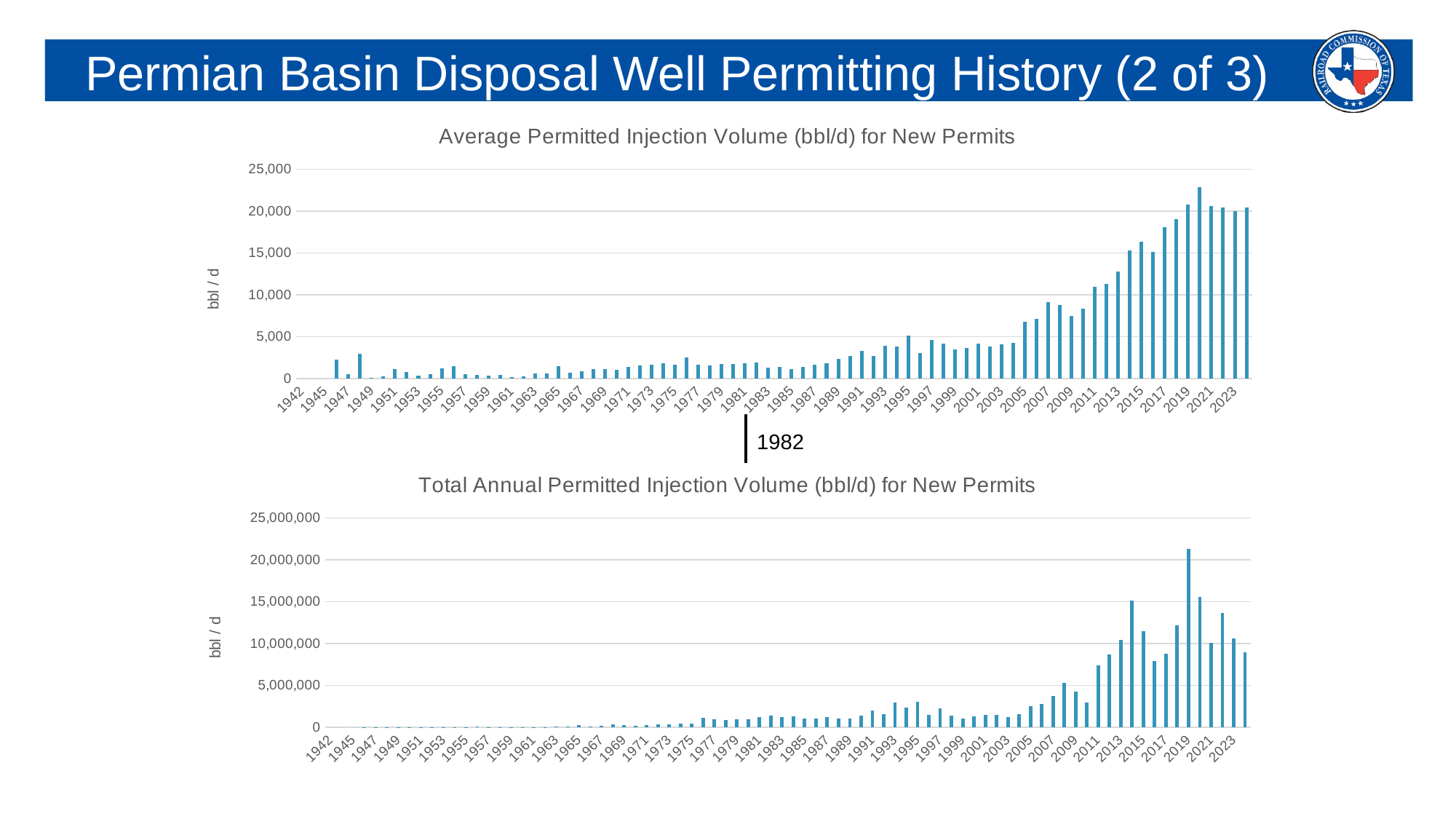
In the top chart (Average Permitted Injection Volume), which year has the highest value? 2020 In the bottom chart (Total Annual Permitted Injection Volume), is the value for 2016 greater or less than 10,000,000? less In the top chart (Average Permitted Injection Volume), is the value for 1982 greater or less than 5,000? less What is the y-axis label on the bottom chart (Total Annual Permitted Injection Volume)? bbl / d In the top chart (Average Permitted Injection Volume), is the value for 2020 greater or less than 20,000? greater In the top chart (Average Permitted Injection Volume), which year has the larger value, 2010 or 2020? 2020 In the bottom chart (Total Annual Permitted Injection Volume), which year has the highest value? 2019 What kind of chart is the top chart, 'Average Permitted Injection Volume (bbl/d) for New Permits'? bar chart In the top chart (Average Permitted Injection Volume), do the values generally rise or fall from 2005 to 2020? rise In the bottom chart (Total Annual Permitted Injection Volume), which year has the larger value, 2019 or 2021? 2019